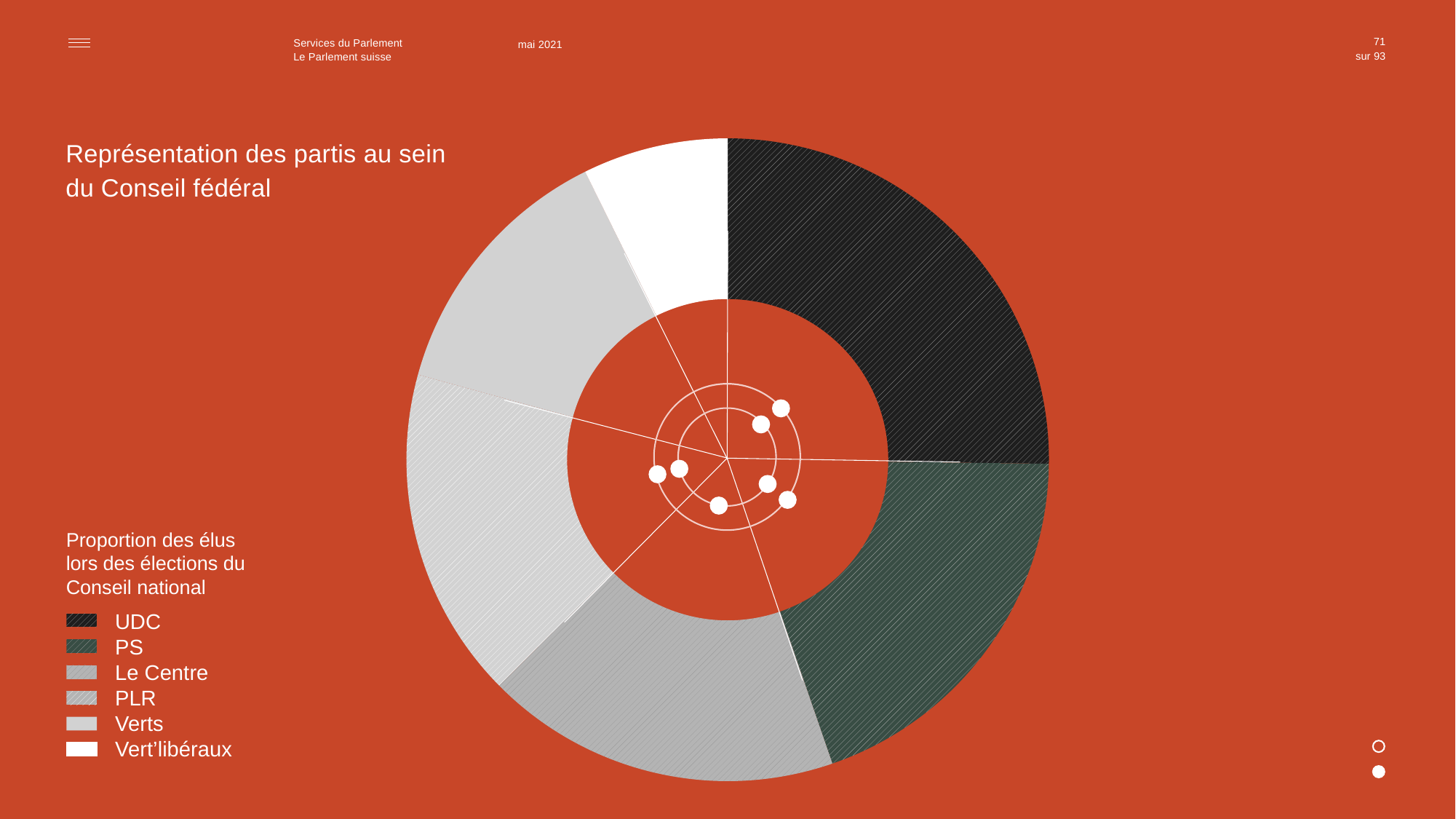
Which slice is larger, UDC or PS? UDC Which party is shown in white in the chart? Vert'libéraux Which party has the smallest slice in the chart? Vert'libéraux What is the title of the chart? Représentation des partis au sein du Conseil fédéral What kind of chart is shown on the slide? Doughnut chart Which slice is larger, PLR or Vert'libéraux? PLR Which party has the largest slice in the chart? UDC How many parties are shown as slices in the chart? 6 How many entries does the legend list? 6 Which slice is larger, Verts or Vert'libéraux? Verts